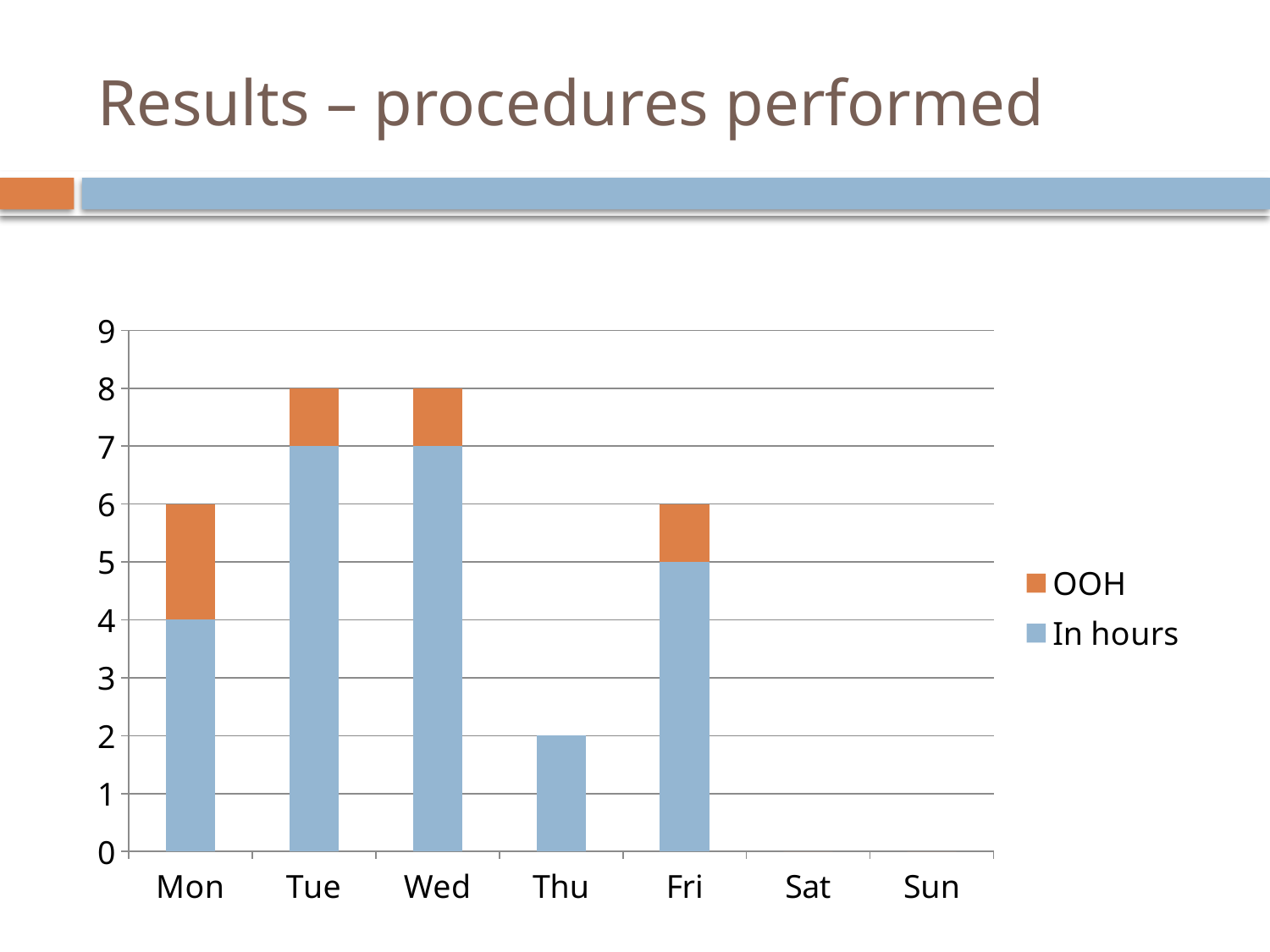
What type of chart is shown on the slide? Stacked bar chart What is the In hours value for Mon? 4 How many series does the legend list? 2 What is the In hours value for Tue? 7 Which day has the lowest In hours value among Mon to Fri? Thu What is the In hours value for Thu? 2 What is the difference between the In hours values for Tue and Mon? 3 What is the total height of the stacked bar for Wed? 8 How many categories are shown on the x axis? 7 What is the total height of the stacked bar for Fri? 6 Which legend entry is shown in orange? OOH Which is larger, the In hours value for Fri or for Thu? Fri